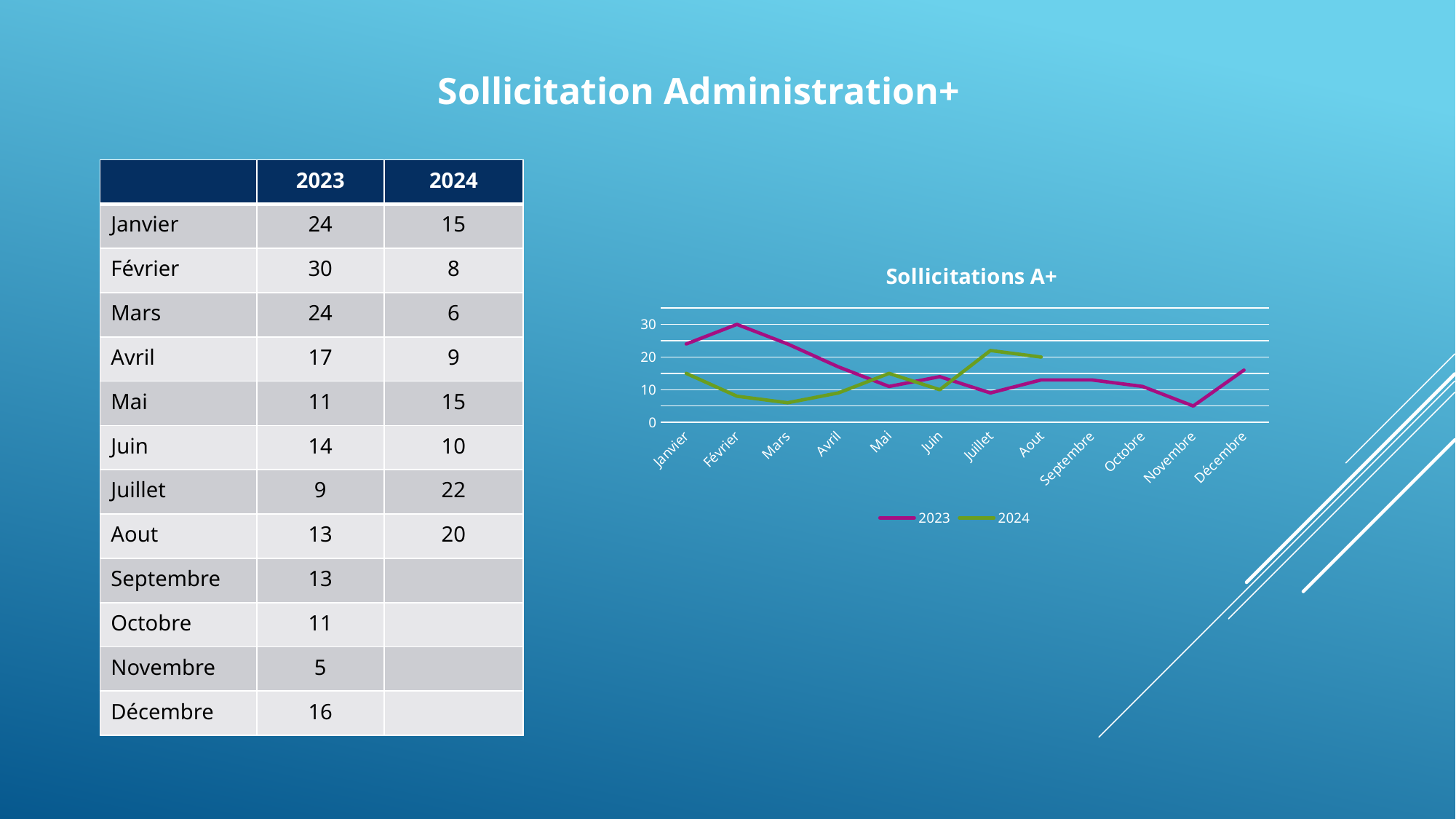
How many series does the chart legend list? 2 What is the value for Juillet in the 2024 series? 22 What is the difference between the 2023 and 2024 values for Février? 22 How many months are shown along the x axis of the chart? 12 Which month has the highest value in the 2023 series? Février What is the value for Février in the 2023 series? 30 What is the title of the chart? Sollicitations A+ Which is larger for Juillet: the 2023 value or the 2024 value? 2024 What kind of chart is shown on the slide? line chart Which month has the lowest value in the 2024 series? Mars Is the 2023 value for Février greater or less than 20? greater Which month has the lowest value in the 2023 series? Novembre